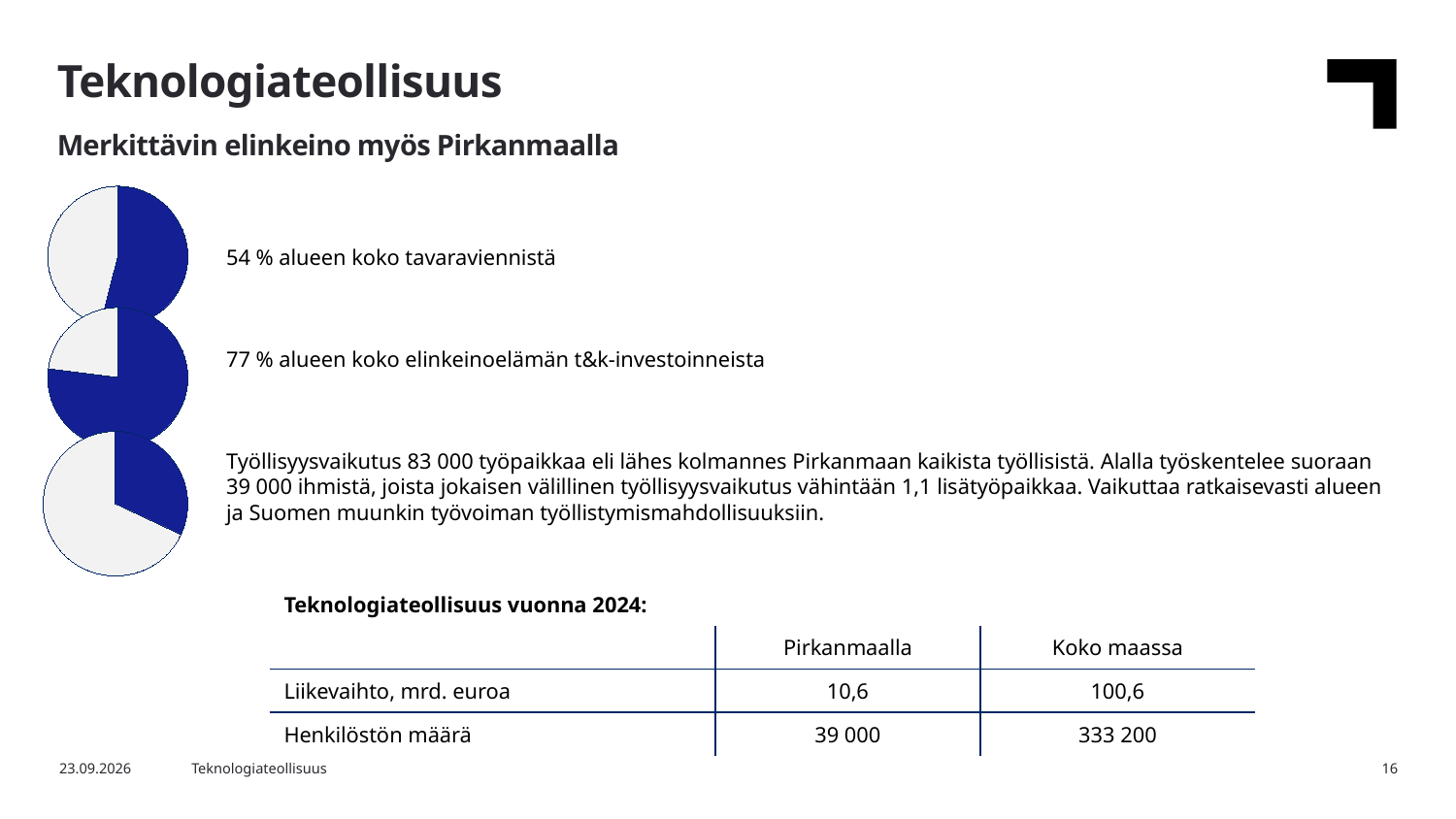
Is the blue slice of the bottom pie chart (työllisyysvaikutus) greater or less than 50% of the pie? less Which pie chart has the larger blue slice, the top one (tavaravienti) or the middle one (t&k-investoinnit)? The middle one (t&k-investoinnit) What colour is used for the highlighted slice in each pie chart? Blue What kind of charts are shown on the left side of the slide? Pie charts Is the blue slice of the middle pie chart (t&k-investoinnit) greater or less than 50% of the pie? greater According to the text next to the middle pie chart, what share of the region's business R&D investments does the technology industry account for? 77 % How many slices does each pie chart have? 2 According to the text next to the top pie chart, what share of the region's total goods exports does the technology industry account for? 54 % What is the difference in percentage points between the share shown for the middle pie chart (77 %) and the top pie chart (54 %)? 23 percentage points Which of the three pie charts has the largest blue slice? The middle one (t&k-investoinnit) Which of the three pie charts has the smallest blue slice? The bottom one (työllisyysvaikutus) How many pie charts are on the slide? 3